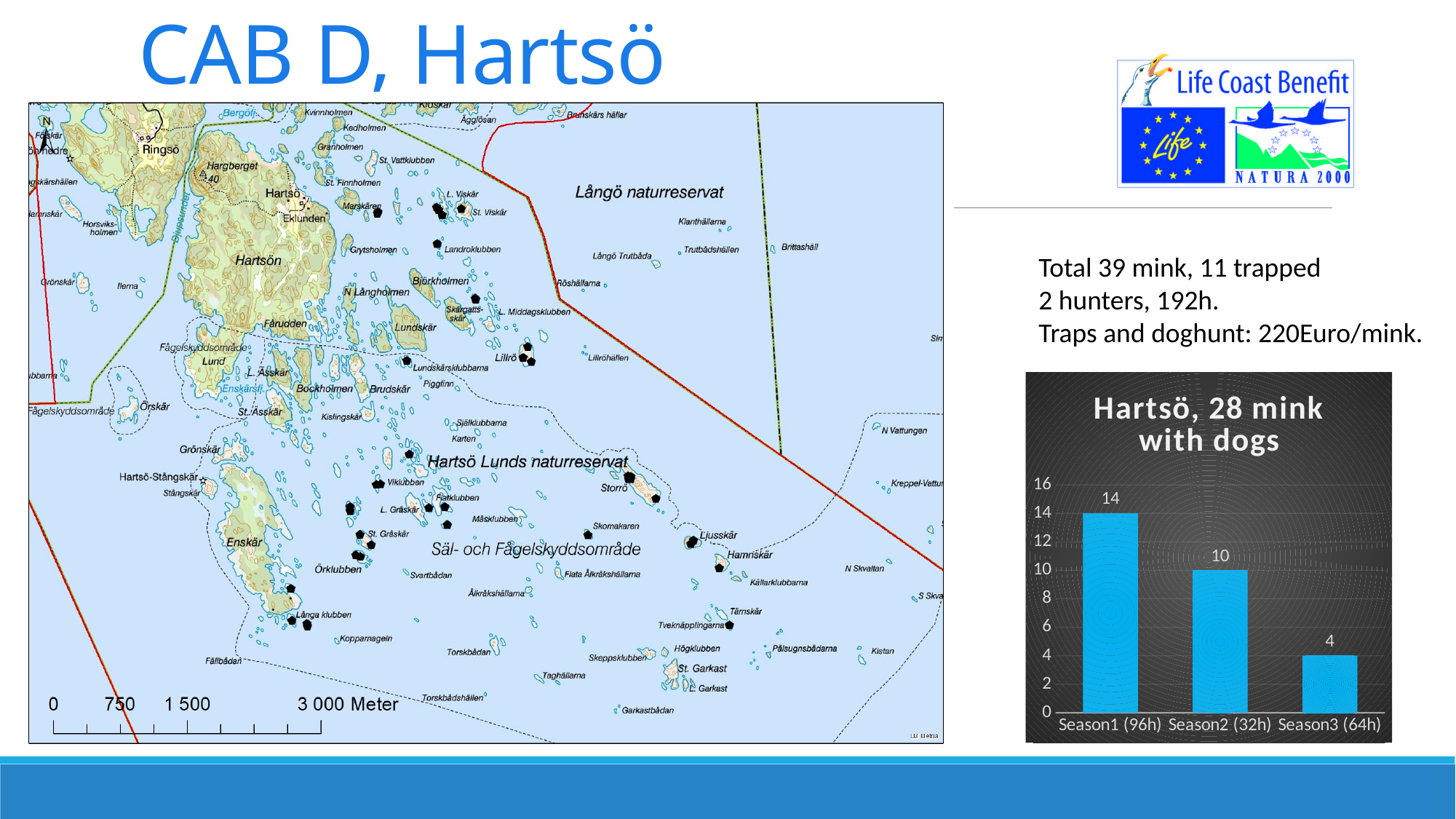
What is the title of the chart? Hartsö, 28 mink with dogs How many categories are shown in the chart? 3 What is the value for Season1 (96h)? 14 Which is larger, the value for Season2 (32h) or Season3 (64h)? Season2 (32h) What is the value for Season3 (64h)? 4 Is the value for Season2 (32h) greater or less than 8? greater What kind of chart is shown on the slide? bar chart Which season has the lowest number of mink? Season3 (64h) What is the difference between the values for Season1 (96h) and Season3 (64h)? 10 Which season has the highest number of mink? Season1 (96h) What is the difference between the values for Season1 (96h) and Season2 (32h)? 4 What is the value for Season2 (32h)? 10